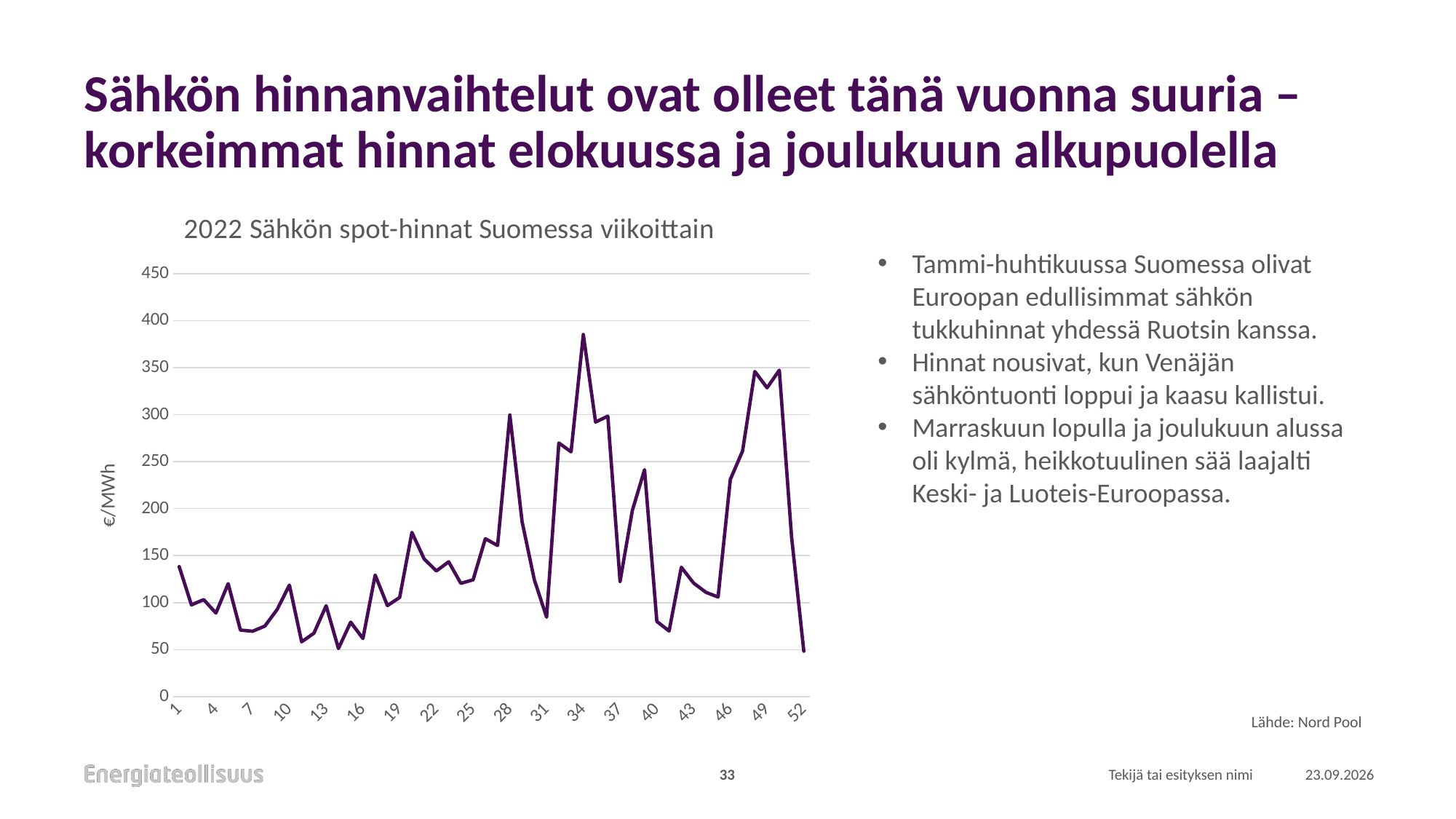
How many weekly data points does the line cover? 52 What is the title of the chart? 2022 Sähkön spot-hinnat Suomessa viikoittain Do the values rise or fall from week 49 to week 52? fall What kind of chart is shown on the slide? line chart Is the value for week 40 greater or less than 100? less Is the value for week 52 greater or less than 100? less Which week has the highest spot price in the chart? 34 Is the value for week 1 greater or less than 100? greater What unit is shown on the vertical axis of the chart? €/MWh Which is larger, the value for week 34 or the value for week 48? week 34